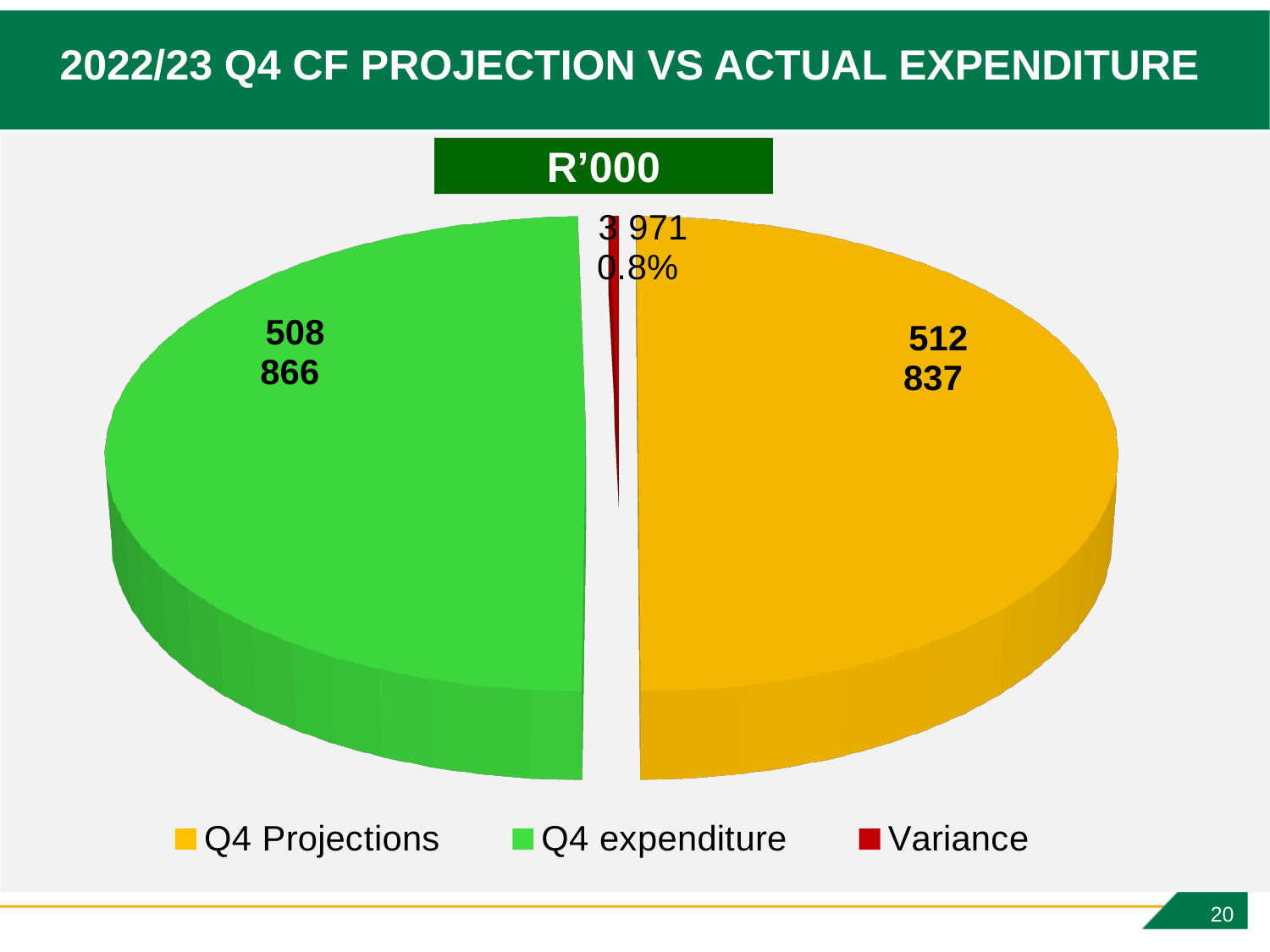
What is the value for Q4 Projections? 512 837 Which is larger, Q4 Projections or Q4 expenditure? Q4 Projections What is the value for Q4 expenditure? 508 866 What percentage share of the pie does the Variance slice represent? 0.8% How many slices does the pie chart have? 3 How many entries does the legend list? 3 What is the difference between Q4 Projections and Q4 expenditure? 3 971 In what unit are the values on the chart expressed, according to the label above the pie? R'000 What is the value for Variance? 3 971 What type of chart is shown on the slide? pie chart Which slice of the pie is the largest? Q4 Projections Which slice of the pie is the smallest? Variance